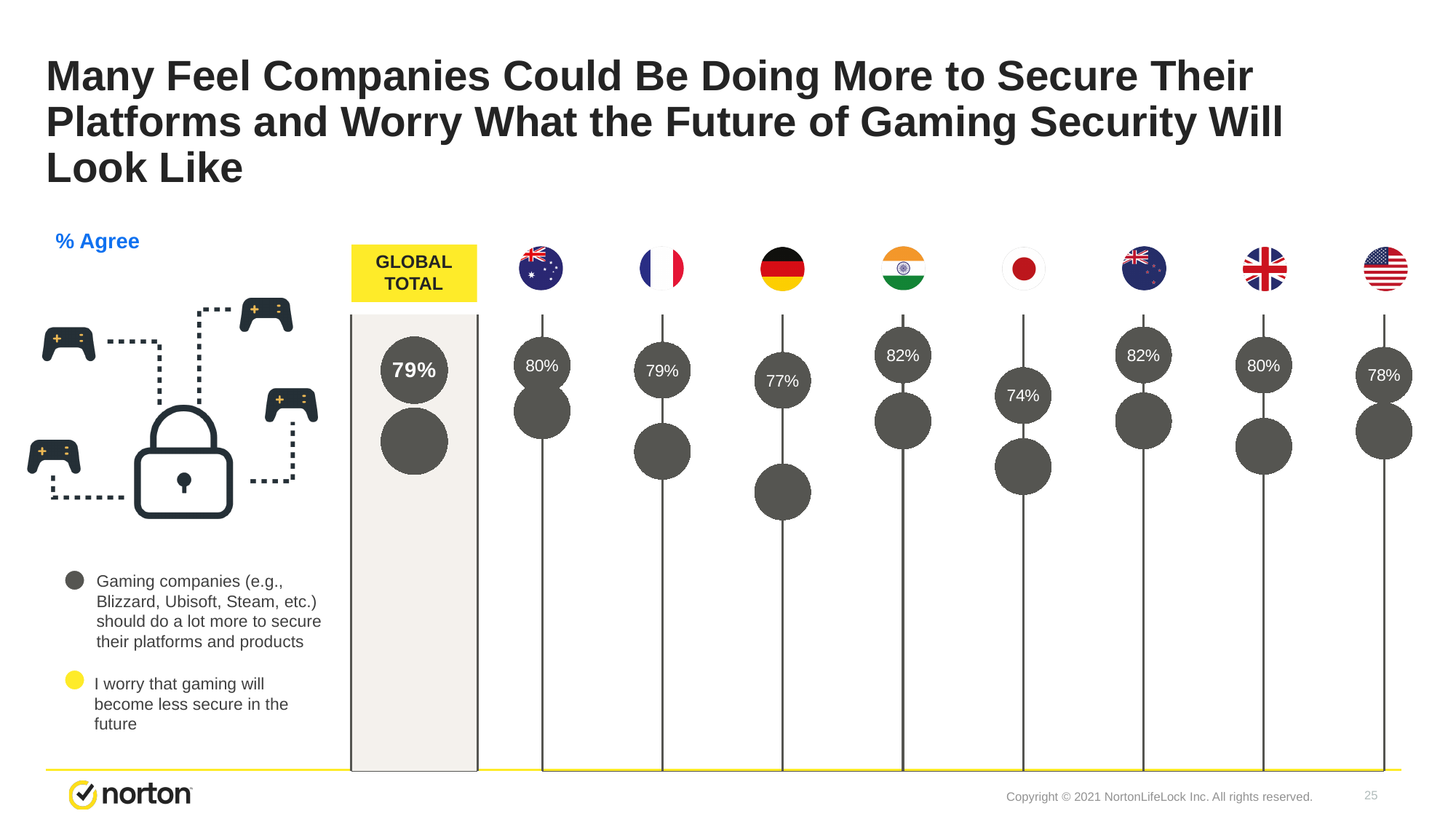
What is the difference in percentage points between India's value (82%) and Japan's value (74%) for the statement that gaming companies should do more? 8 percentage points How many statements does the legend list? 2 What is the Global Total value for the statement that gaming companies should do a lot more to secure their platforms and products? 79% What percentage of respondents in Japan (Japanese flag) agree that gaming companies should do a lot more to secure their platforms and products? 74% Which country has the lowest labelled percentage agreeing that gaming companies should do a lot more to secure their platforms? Japan Which two countries share the highest labelled percentage (82%) agreeing that gaming companies should do a lot more to secure their platforms? India and New Zealand What kind of chart is used to show the % Agree values? Dot plot How many columns (Global Total plus countries) are plotted on the chart? 9 What statement does the yellow dot in the legend represent? I worry that gaming will become less secure in the future What percentage of respondents in Germany (German flag) agree that gaming companies should do a lot more to secure their platforms and products? 77% What percentage of respondents in the United Kingdom (UK flag) agree that gaming companies should do a lot more to secure their platforms and products? 80% Which has a higher labelled value for the statement that gaming companies should do more: the United States (78%) or Germany (77%)? United States